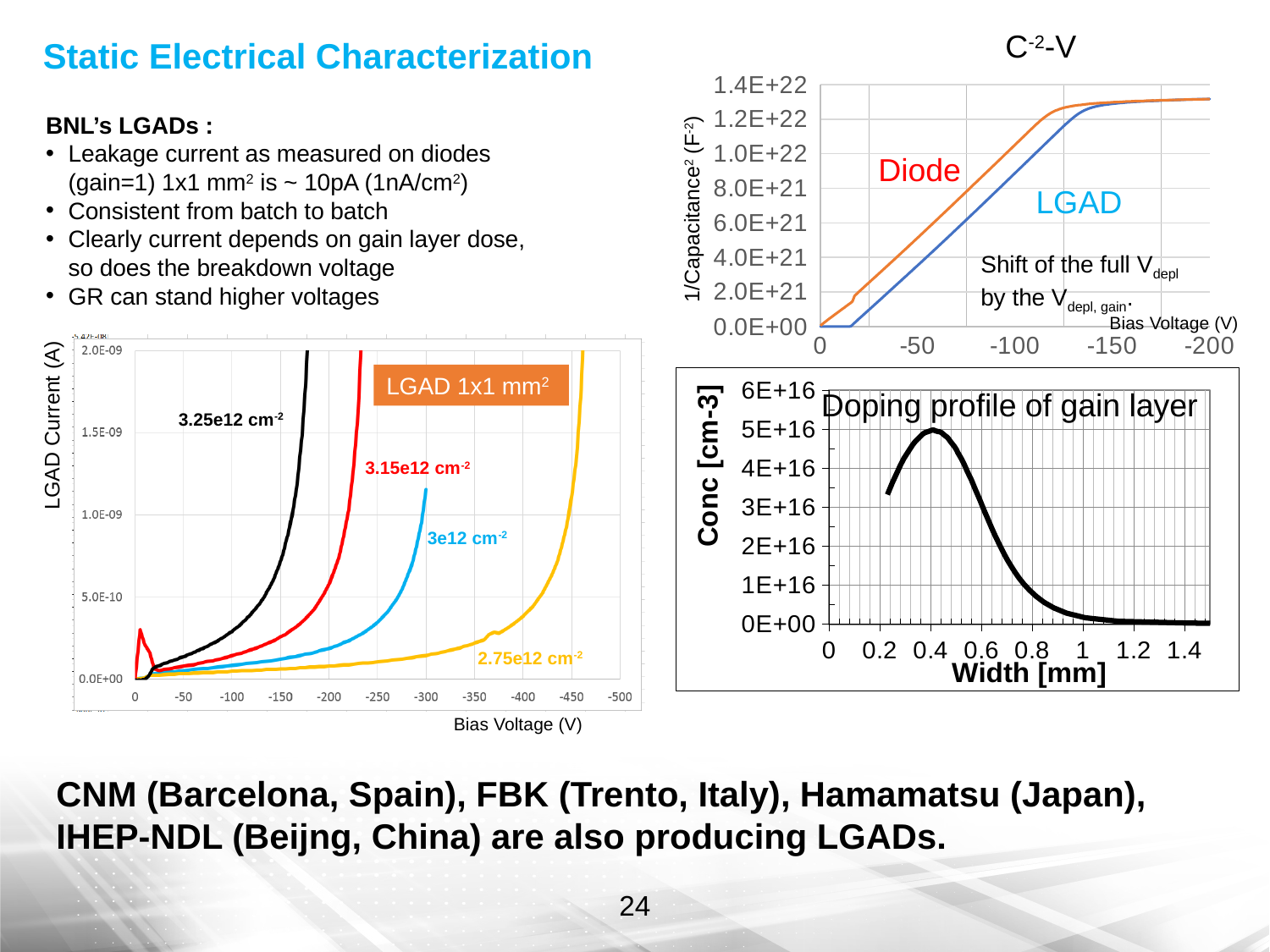
In the LGAD current vs bias voltage chart, what is the label of the y axis? LGAD Current (A) In the LGAD current vs bias voltage chart, is the bias voltage magnitude at which the 2.75e12 cm⁻² curve shoots up greater or less than 400 V? greater In the C⁻²-V chart, is the plateau value of the LGAD curve greater or less than 1.2E+22? greater What kind of chart is the C⁻²-V chart at the top right? line chart In the C⁻²-V chart, which curve reaches its plateau at a lower bias voltage magnitude, Diode or LGAD? Diode In the LGAD current vs bias voltage chart, which dose curve breaks down at the smallest bias voltage magnitude? 3.25e12 cm⁻² In the C⁻²-V chart, how many curves are plotted? 2 In the LGAD current vs bias voltage chart at the bottom left, how many gain-layer dose curves are plotted? 4 In the C⁻²-V chart, what is the label of the y axis? 1/Capacitance² (F⁻²) In the LGAD current vs bias voltage chart, which dose curve breaks down at the largest bias voltage magnitude? 2.75e12 cm⁻² In the Doping profile of gain layer chart, is the peak concentration greater or less than 4E+16? greater